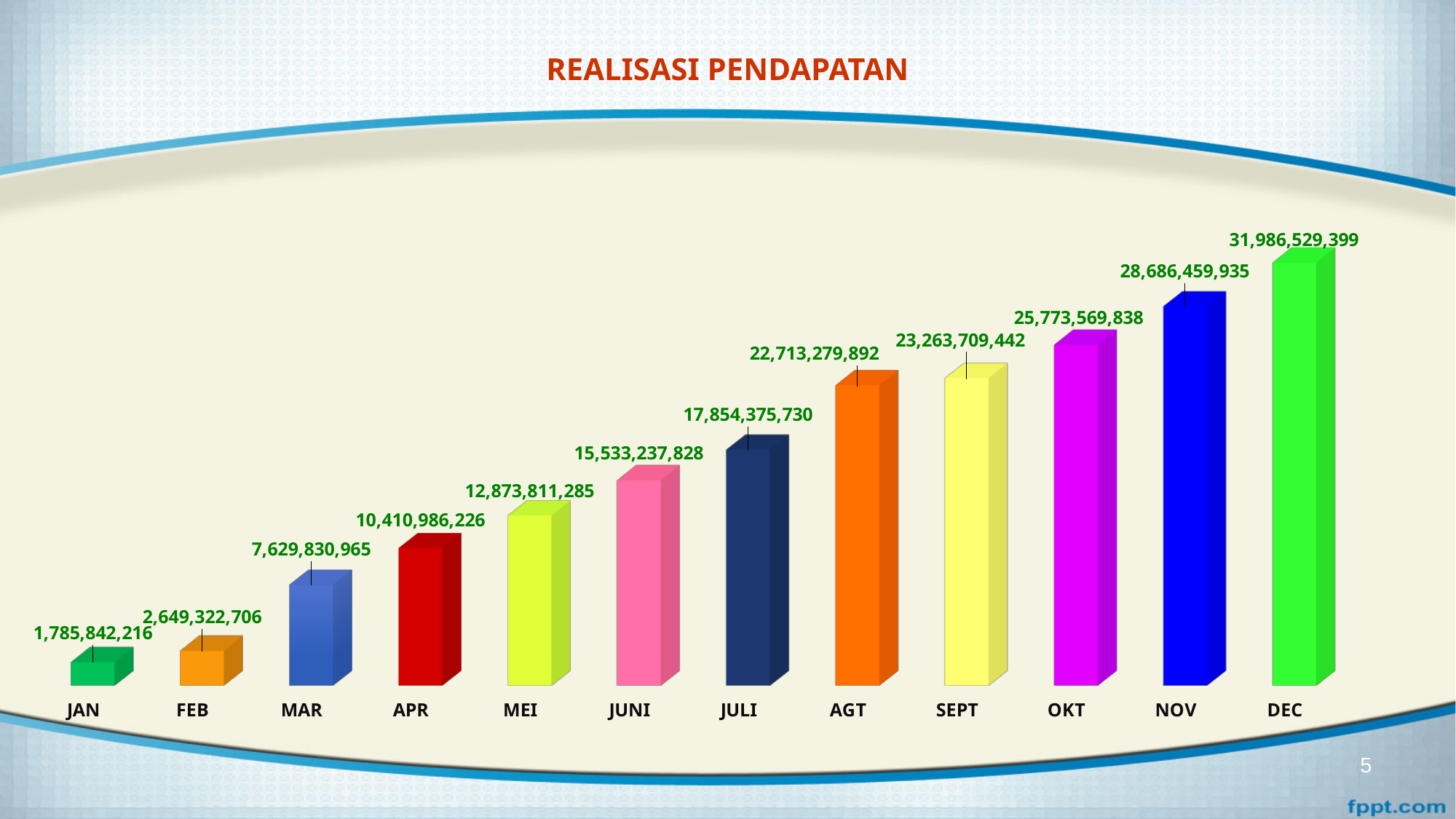
What is the value for MAR? 7,629,830,965 What is the difference between the values for FEB and JAN? 863,480,490 Which month has the highest value? DEC Which is larger, the value for SEPT or the value for JULI? SEPT What kind of chart is shown on the slide? bar chart How many months are shown on the chart? 12 What is the title of the chart? REALISASI PENDAPATAN What is the value for AGT? 22,713,279,892 What is the difference between the values for DEC and NOV? 3,300,069,464 Do the values rise or fall from JAN to DEC? rise What is the value for JUNI? 15,533,237,828 Which month has the lowest value? JAN